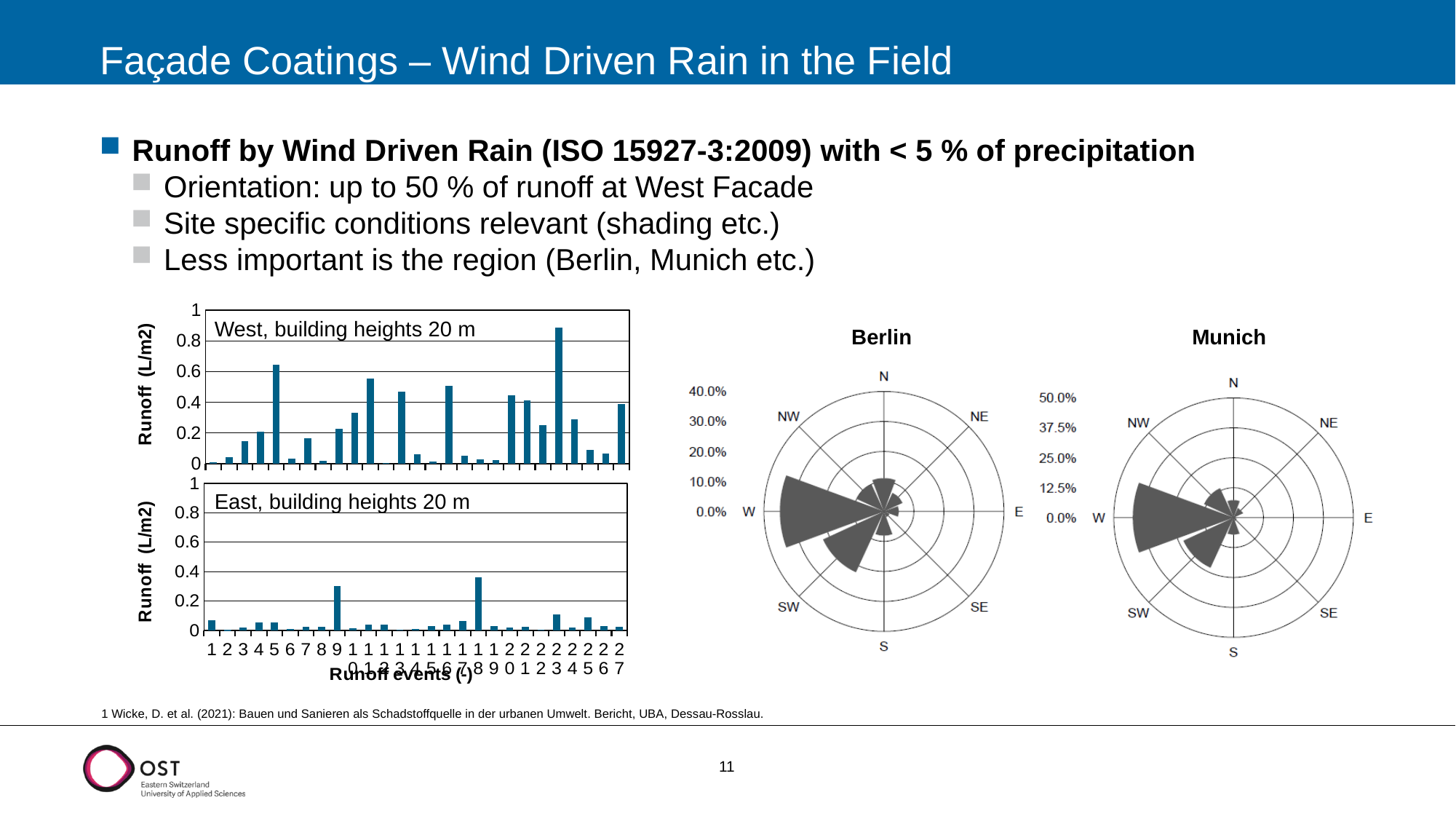
What kind of chart is the 'West, building heights 20 m' chart? bar chart In the Berlin wind rose chart, which sector is larger, W or E? W In the Berlin wind rose chart, is the W sector greater or less than 20.0%? greater In the Munich wind rose chart, which direction has the largest sector? W In the 'East, building heights 20 m' chart, is the highest bar greater or less than 0.4? less Which chart has the larger maximum runoff value, 'West, building heights 20 m' or 'East, building heights 20 m'? West, building heights 20 m What is the label of the x axis shared by the West and East bar charts? Runoff events (-) In the Berlin wind rose chart, which direction has the largest sector? W In the 'East, building heights 20 m' chart, is the highest bar greater or less than 0.2? greater What is the label of the y axis on the 'West, building heights 20 m' chart? Runoff (L/m2)